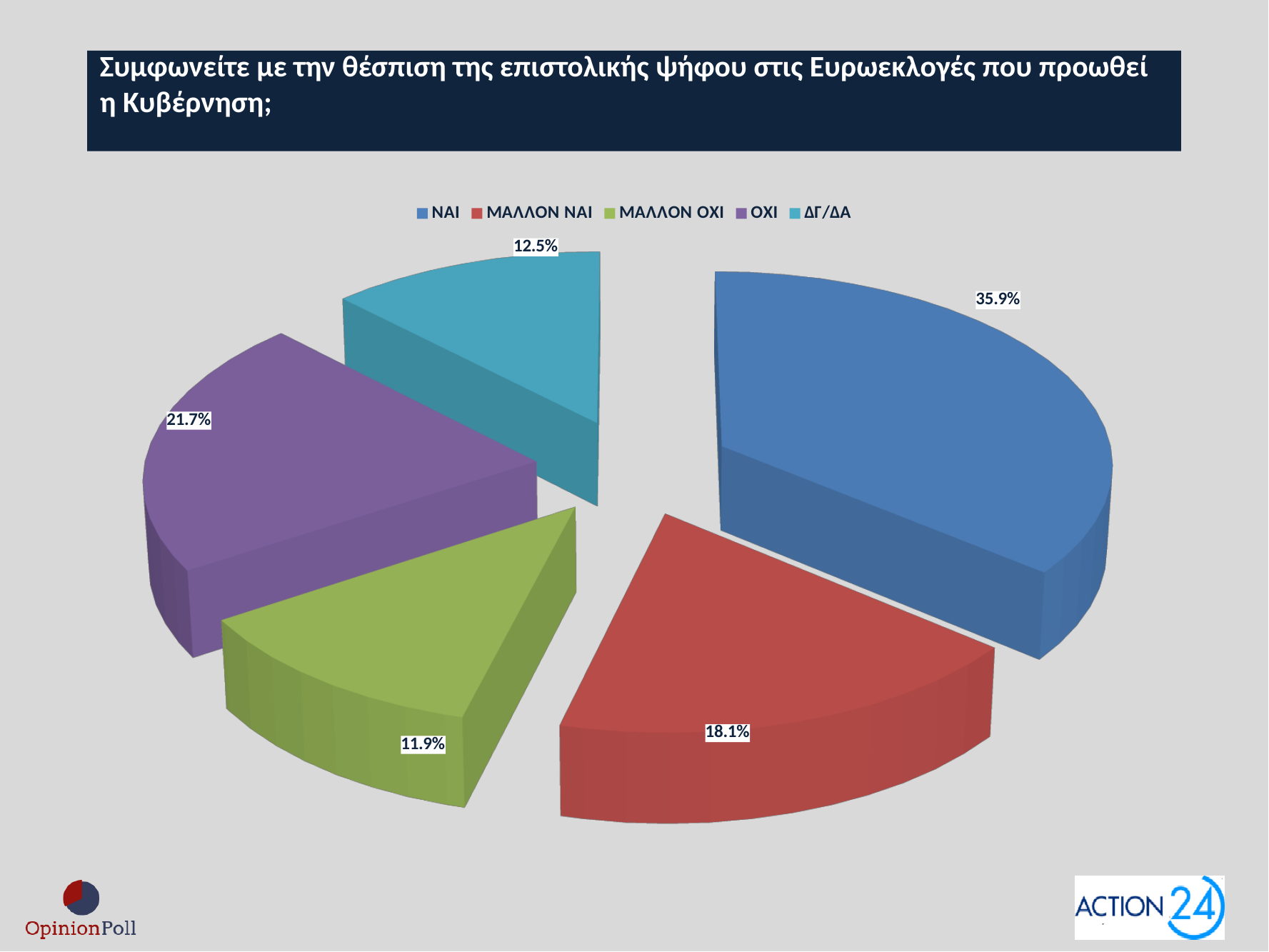
Which response has the largest share of the pie? ΝΑΙ What kind of chart is shown on the slide? Pie chart What colour is the slice for ΟΧΙ? Purple What percentage of respondents answered ΜΑΛΛΟΝ ΝΑΙ? 18.1% How many categories does the legend list? 5 What percentage of respondents answered ΟΧΙ? 21.7% Which is larger, the share for ΜΑΛΛΟΝ ΝΑΙ or the share for ΔΓ/ΔΑ? ΜΑΛΛΟΝ ΝΑΙ Which response has the smallest share of the pie? ΜΑΛΛΟΝ ΟΧΙ What percentage of respondents answered ΜΑΛΛΟΝ ΟΧΙ? 11.9% What percentage of respondents answered ΔΓ/ΔΑ? 12.5% What percentage of respondents answered ΝΑΙ? 35.9% What is the difference in percentage points between ΝΑΙ and ΟΧΙ? 14.2